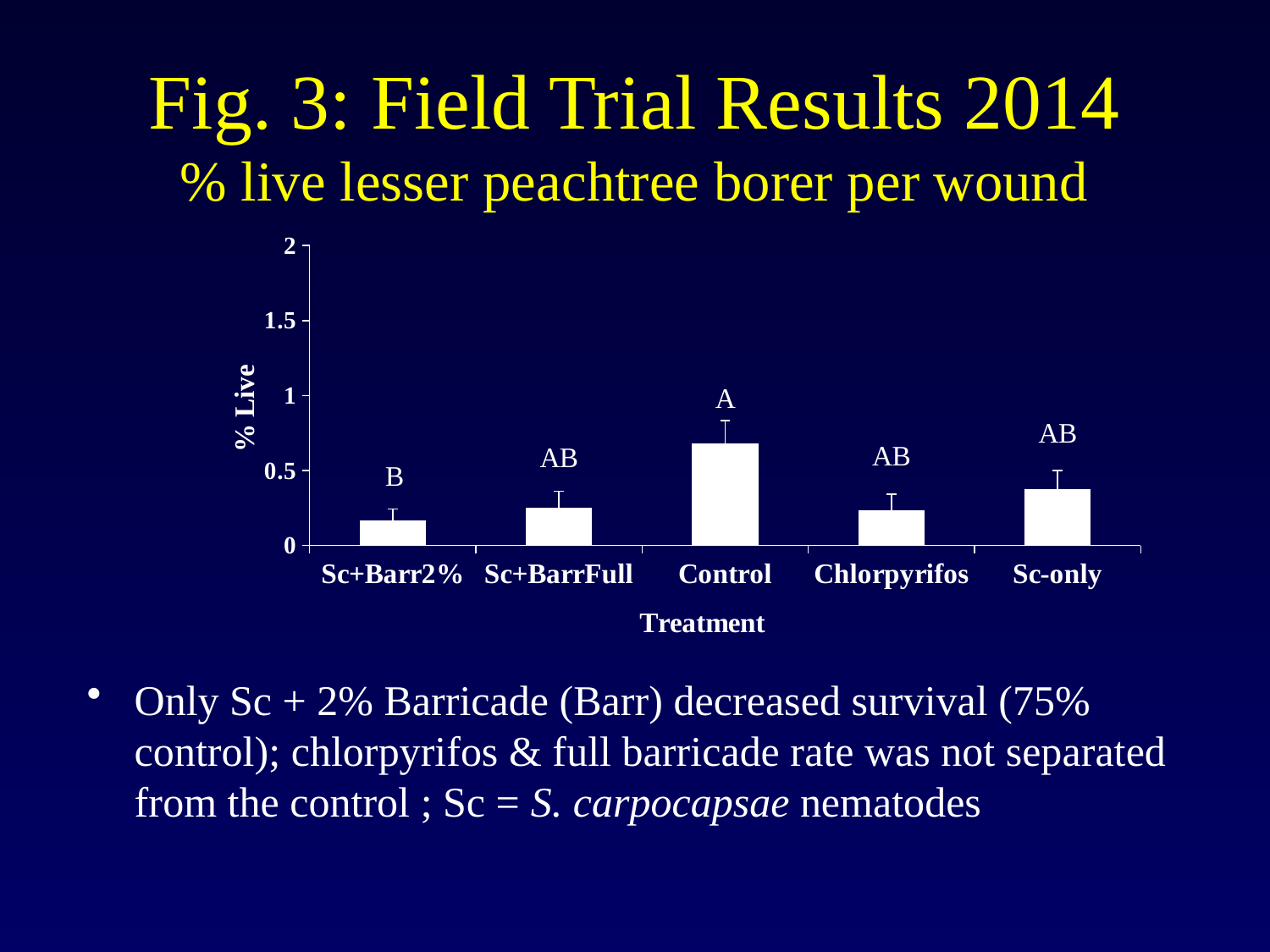
Which is larger, the value for Sc-only or the value for Sc+Barr2%? Sc-only Is the value for Control greater or less than 1? less Is the value for Control greater or less than 0.5? greater Is the value for Sc-only greater or less than 0.5? less What is the title of the x axis? Treatment How many treatment categories are plotted on the x axis? 5 What kind of chart is shown on the slide? bar chart Which treatment has the highest % Live value? Control What letter is printed above the Control bar? A Which is larger, the value for Control or the value for Sc-only? Control Which treatment has the lowest % Live value? Sc+Barr2%